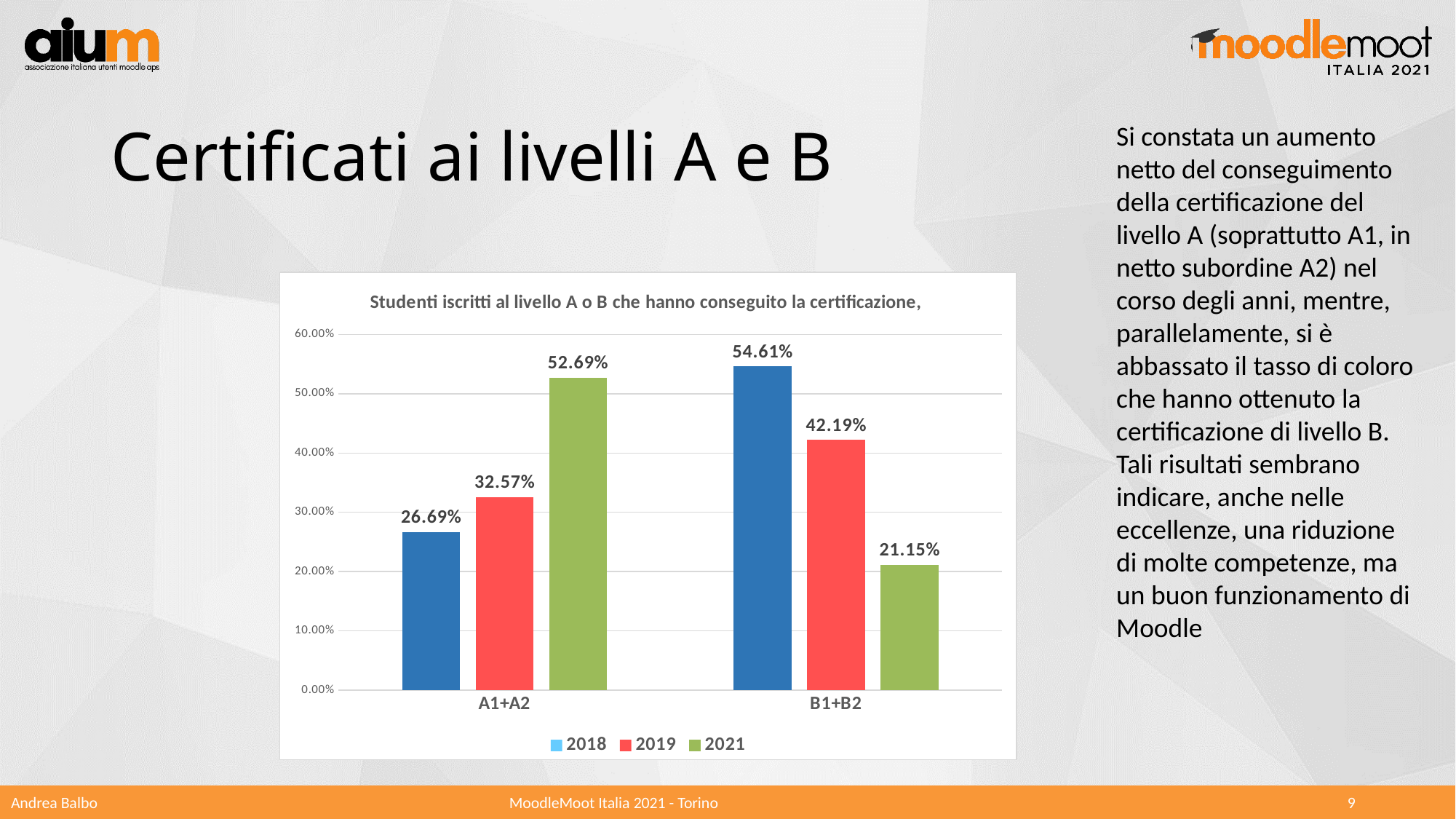
What is the value for 2018 in the B1+B2 category? 54.61% Which year has the highest value in the B1+B2 category? 2018 What is the value for 2019 in the A1+A2 category? 32.57% What is the difference between the 2018 and 2021 values in the B1+B2 category? 33.46% Which is larger: the 2019 value for A1+A2 or the 2019 value for B1+B2? B1+B2 What is the value for 2021 in the B1+B2 category? 21.15% Which year has the lowest value in the A1+A2 category? 2018 How many series does the legend list? 3 What is the difference between the 2021 and 2018 values in the A1+A2 category? 26.00% Do the values for the B1+B2 category rise or fall from 2018 to 2021? Fall What kind of chart is shown on the slide? Bar chart What is the value for 2021 in the A1+A2 category? 52.69%